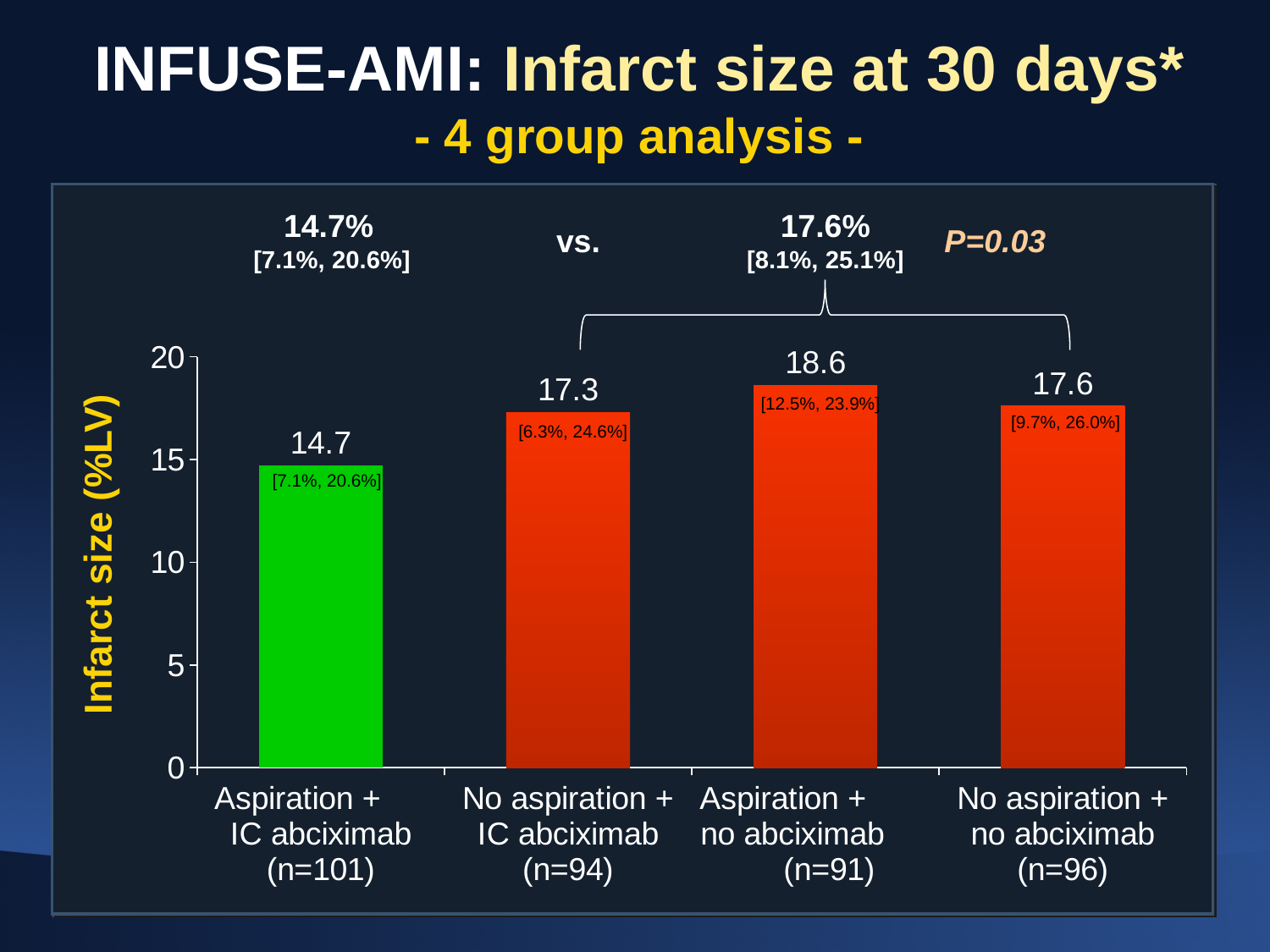
What is the infarct size for the No aspiration + no abciximab group? 17.6 Which group has the highest infarct size? Aspiration + no abciximab What is the infarct size for the Aspiration + IC abciximab group? 14.7 What is the infarct size for the Aspiration + no abciximab group? 18.6 What is the infarct size for the No aspiration + IC abciximab group? 17.3 What type of chart is shown on the slide? Bar chart What is the P value shown on the slide for the comparison? P=0.03 Which group has the lowest infarct size? Aspiration + IC abciximab Which group has a larger infarct size, No aspiration + IC abciximab or Aspiration + IC abciximab? No aspiration + IC abciximab How many groups are shown in the chart? 4 What is the difference in infarct size between the Aspiration + no abciximab group and the Aspiration + IC abciximab group? 3.9 Is the infarct size for the Aspiration + IC abciximab group greater or less than 15? less